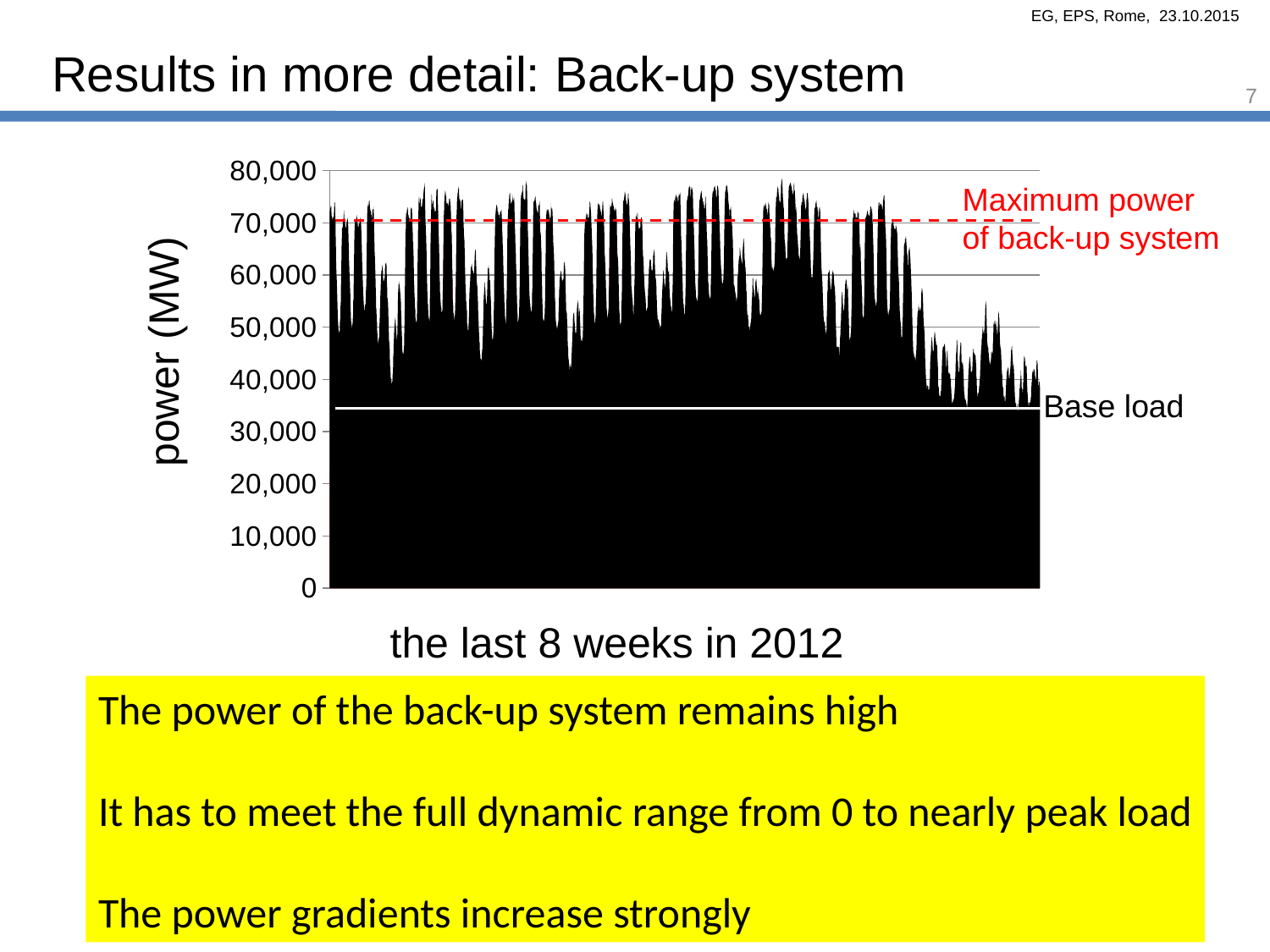
What time period does the chart cover, according to the caption below it? the last 8 weeks in 2012 Is the base load line greater or less than 40,000 MW? less Do the plotted power values rise or fall toward the right end of the chart? fall What is the label of the vertical axis of the chart? power (MW) What is the highest value shown on the vertical axis of the chart? 80,000 Is the dashed red line marking the maximum power of the back-up system greater or less than 60,000 MW? greater Is the base load line greater or less than 30,000 MW? greater What kind of chart is shown on the slide? area chart How many tick labels are shown on the vertical axis of the chart? 9